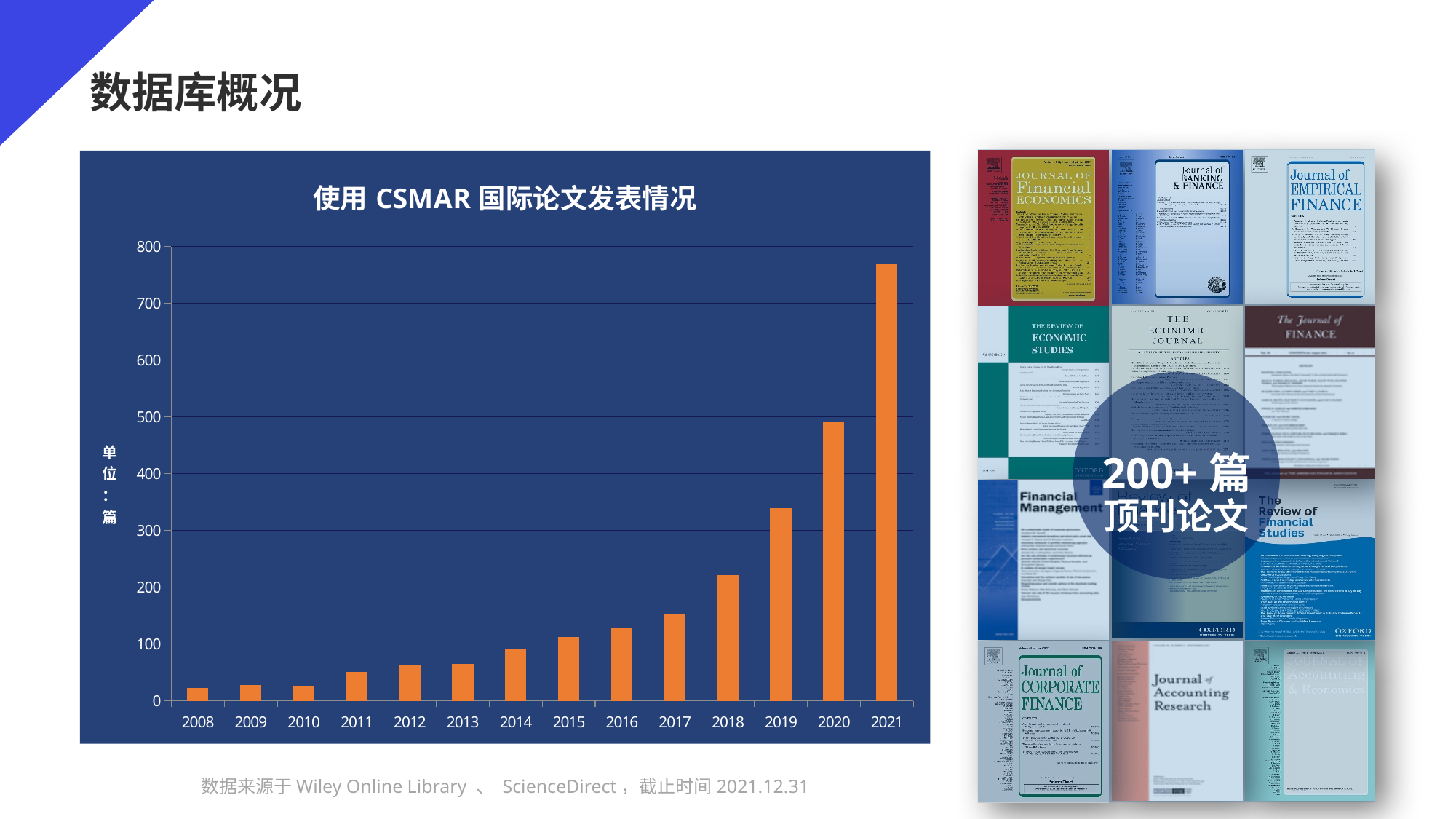
Do the values generally rise or fall from 2008 to 2021? Rise Is the value for 2019 greater or less than 300? greater What kind of chart is shown on the slide? Bar chart Is the value for 2017 greater or less than 100? greater Which year has the larger value, 2019 or 2020? 2020 What is the title of the chart? 使用 CSMAR 国际论文发表情况 How many years are shown on the x axis of the chart? 14 Is the value for 2021 greater or less than 700? greater Which year has the highest number of publications in the chart? 2021 What unit is given on the y axis of the chart? 篇